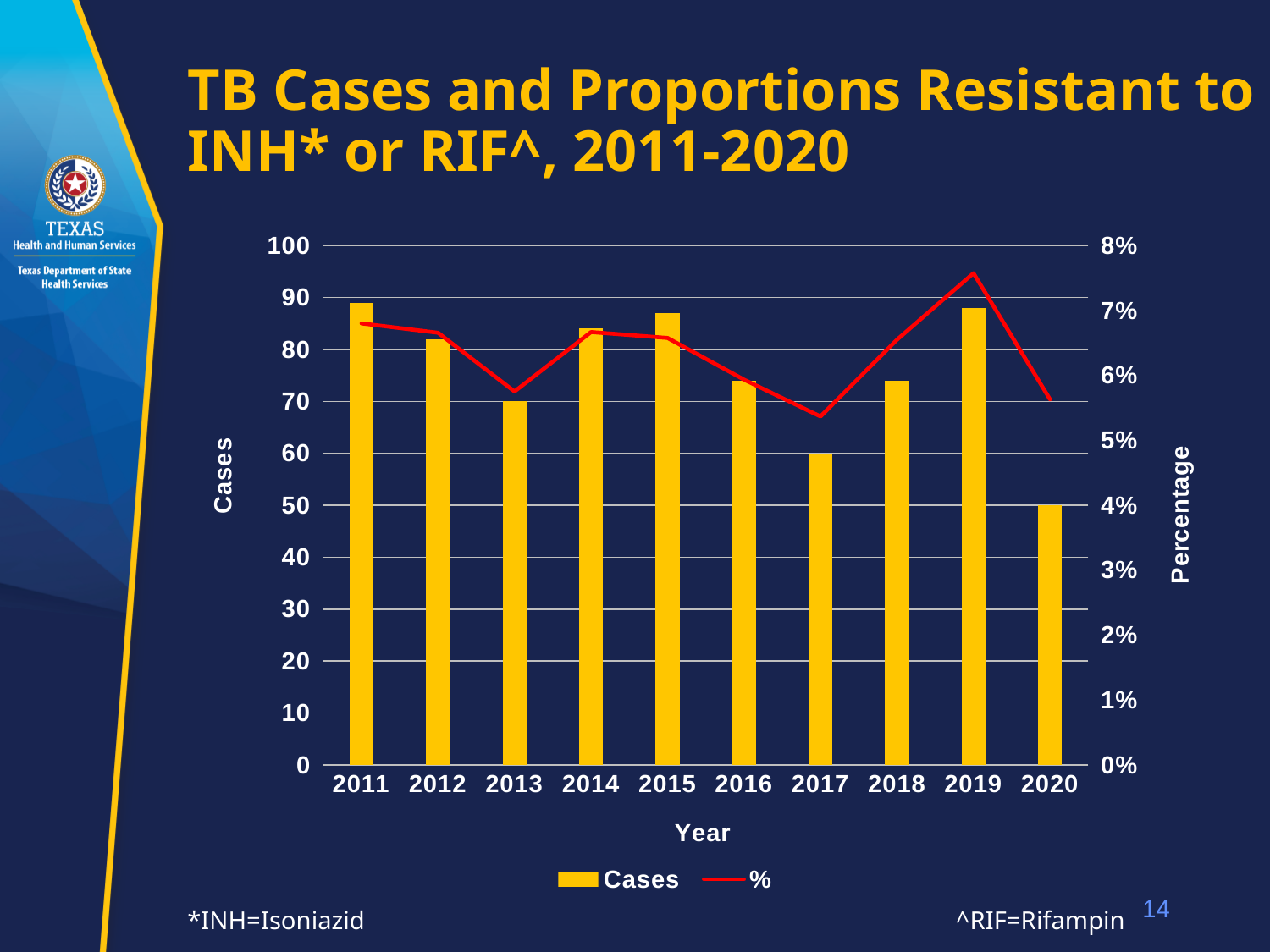
Which year has the lowest number of cases? 2020 Is the number of cases for 2011 greater or less than 80? greater How many cases are shown for 2017? 60 Is the percentage for 2017 greater or less than 6%? less How many cases are shown for 2020? 50 Is the percentage for 2019 greater or less than 7%? greater How many cases are shown for 2013? 70 Which year has the highest percentage resistant? 2019 What kind of chart is this? Combined bar and line chart How many years are shown on the x axis? 10 Which year has more cases, 2015 or 2016? 2015 How many series does the legend list? 2